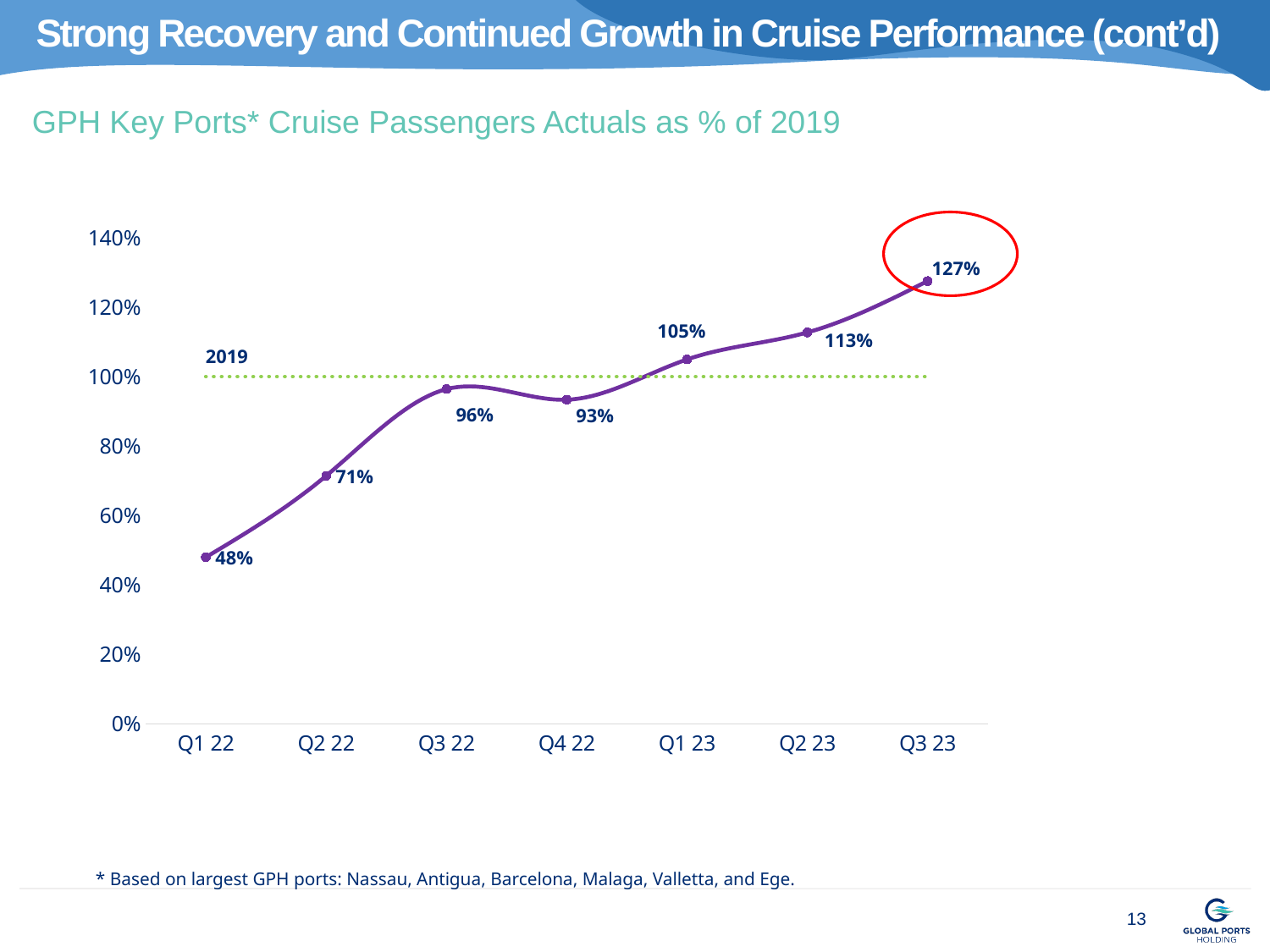
What is the difference between the values for Q3 23 and Q1 22? 79% What is the value for Q4 22? 93% Which quarter has the lowest value? Q1 22 What is the value for Q3 23? 127% What is the difference between the values for Q3 22 and Q4 22? 3% Do the values generally rise or fall from Q1 22 to Q3 23? rise What is the title of the chart? GPH Key Ports* Cruise Passengers Actuals as % of 2019 Which is larger, the value for Q2 22 or the value for Q1 23? Q1 23 What is the value for Q1 22? 48% Which quarter has the highest value? Q3 23 How many quarters are plotted on the chart? 7 What kind of chart is shown? line chart